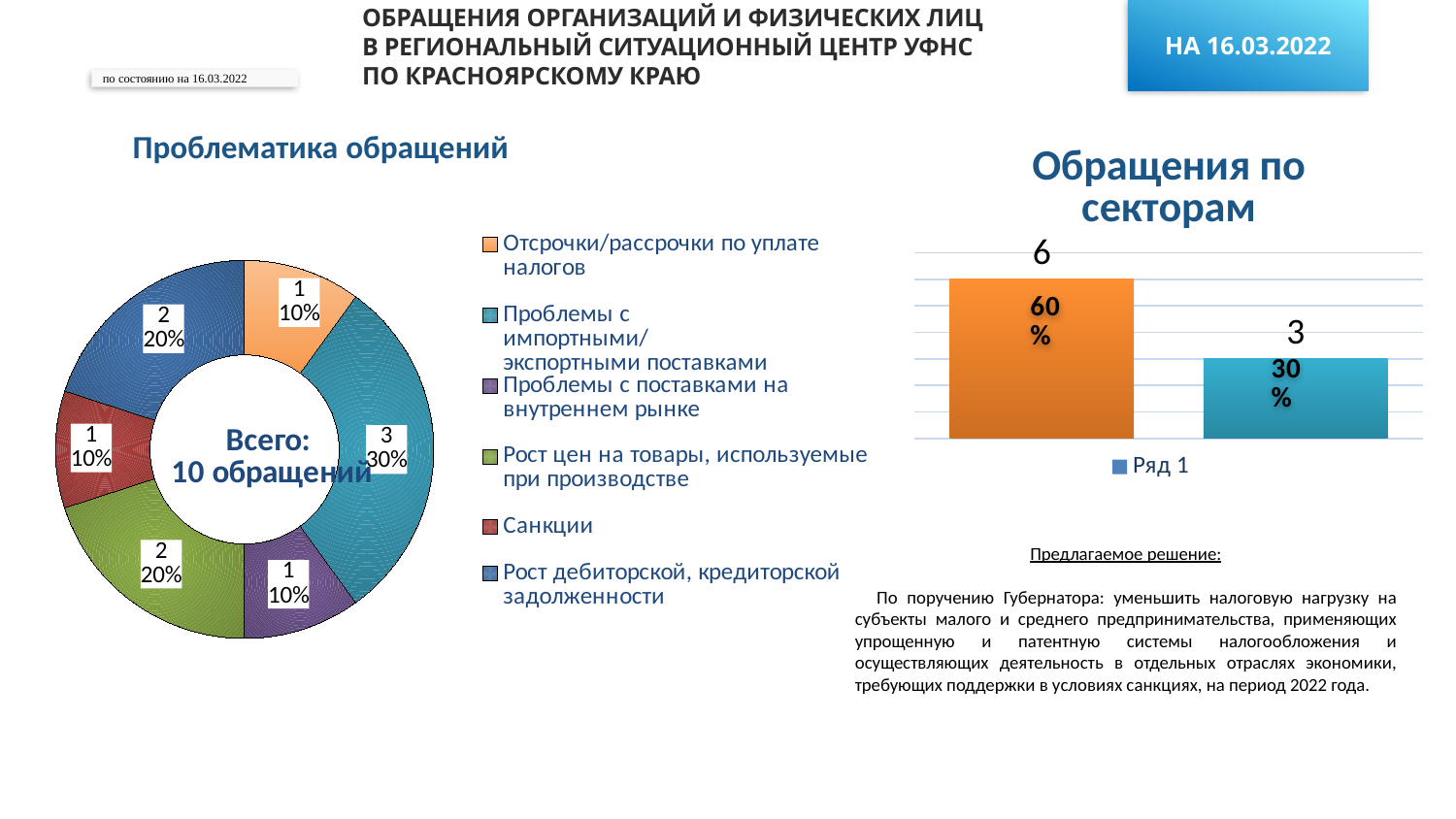
In the chart 'Обращения по секторам', what is the value of the left (orange) bar? 6 In the chart 'Обращения по секторам', what percentage is shown on the right (teal) bar? 30% In the doughnut chart 'Проблематика обращений', how many categories does the legend list? 6 In the doughnut chart 'Проблематика обращений', which is larger: 'Рост цен на товары, используемые при производстве' or 'Отсрочки/рассрочки по уплате налогов'? Рост цен на товары, используемые при производстве In the doughnut chart 'Проблематика обращений', what share of appeals is 'Рост дебиторской, кредиторской задолженности'? 20% In the doughnut chart 'Проблематика обращений', how many appeals relate to 'Проблемы с импортными/экспортными поставками'? 3 In the doughnut chart 'Проблематика обращений', what is the total number of appeals shown in the centre? 10 обращений In the doughnut chart 'Проблематика обращений', what is the difference in appeals between 'Проблемы с импортными/экспортными поставками' and 'Проблемы с поставками на внутреннем рынке'? 2 In the doughnut chart 'Проблематика обращений', which category has the largest share? Проблемы с импортными/экспортными поставками In the chart 'Обращения по секторам', what is the difference between the two bars? 3 In the doughnut chart 'Проблематика обращений', what share of appeals is 'Санкции'? 10% What kind of chart is 'Обращения по секторам'? bar chart